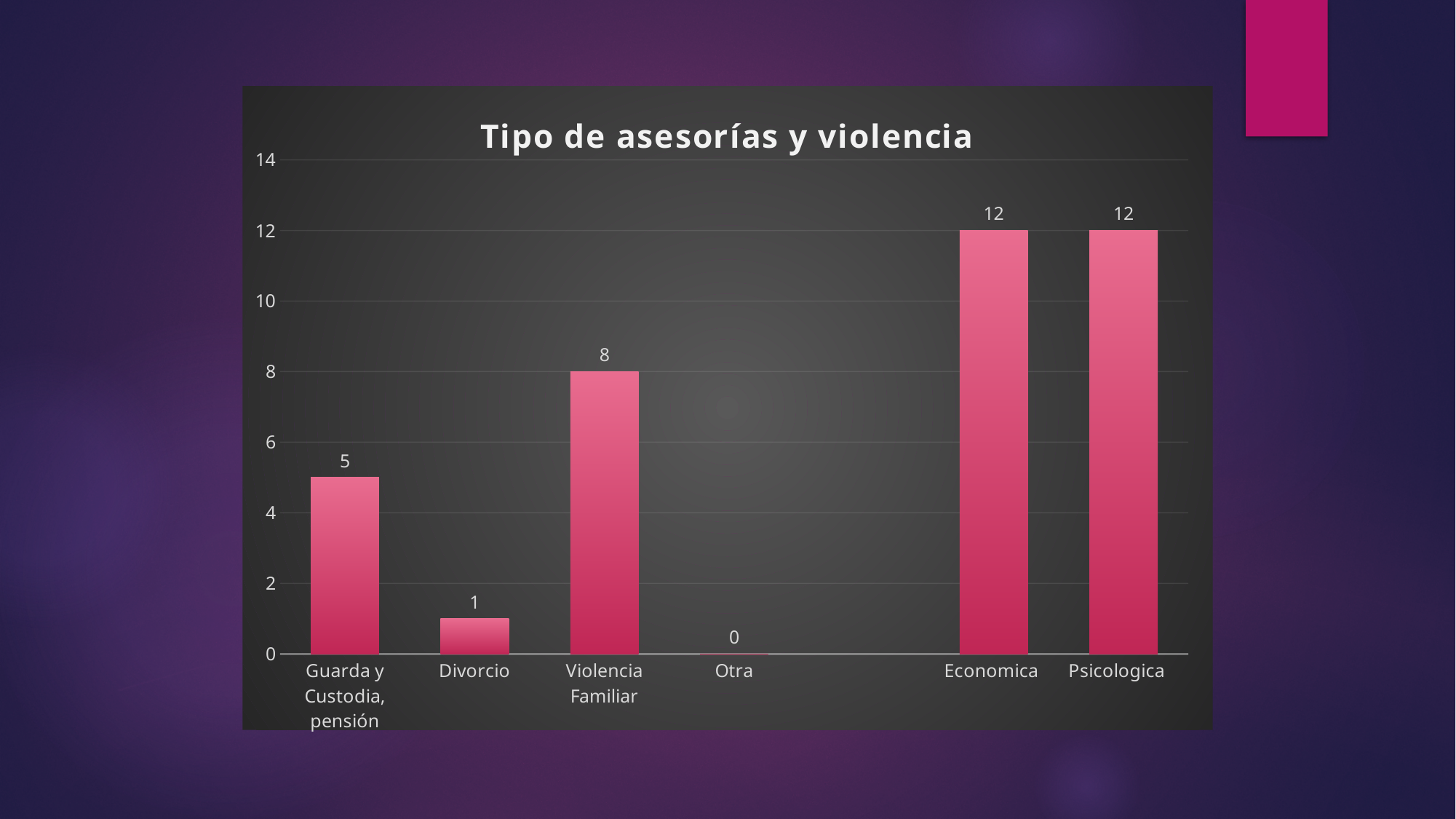
What is the value for Economica? 12 What kind of chart is shown on the slide? Bar chart Is the value for Violencia Familiar greater or less than 6? greater Which category has the lowest value? Otra What is the difference between the values for Violencia Familiar and Guarda y Custodia, pensión? 3 What is the value for Violencia Familiar? 8 What is the value for Divorcio? 1 Which is larger, the value for Divorcio or the value for Guarda y Custodia, pensión? Guarda y Custodia, pensión What is the value for Guarda y Custodia, pensión? 5 What is the title of the chart? Tipo de asesorías y violencia Is the value for Psicologica greater or less than 10? greater What is the difference between the values for Economica and Violencia Familiar? 4